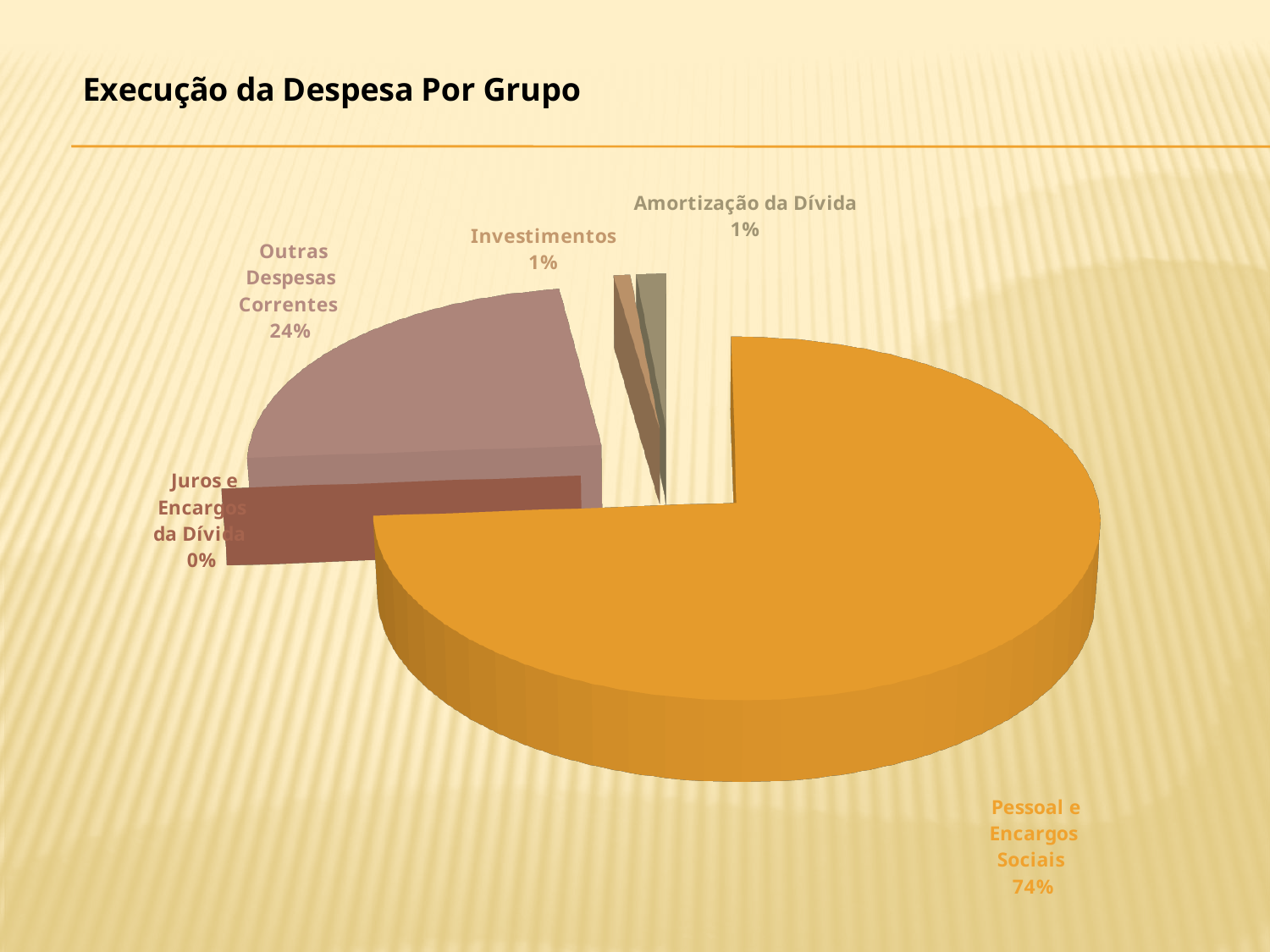
What kind of chart is shown on the slide? Pie chart What percentage is shown for Juros e Encargos da Dívida? 0% Which category has the largest slice of the pie? Pessoal e Encargos Sociais How many categories are shown in the pie chart? 5 What percentage is shown for Investimentos? 1% What is the difference in percentage points between Pessoal e Encargos Sociais and Outras Despesas Correntes? 50 What percentage is shown for Amortização da Dívida? 1% What is the title of the slide? Execução da Despesa Por Grupo What share of the pie does Outras Despesas Correntes represent? 24% What share of the pie does Pessoal e Encargos Sociais represent? 74% Which is larger, Outras Despesas Correntes or Investimentos? Outras Despesas Correntes Which category has the smallest slice of the pie? Juros e Encargos da Dívida